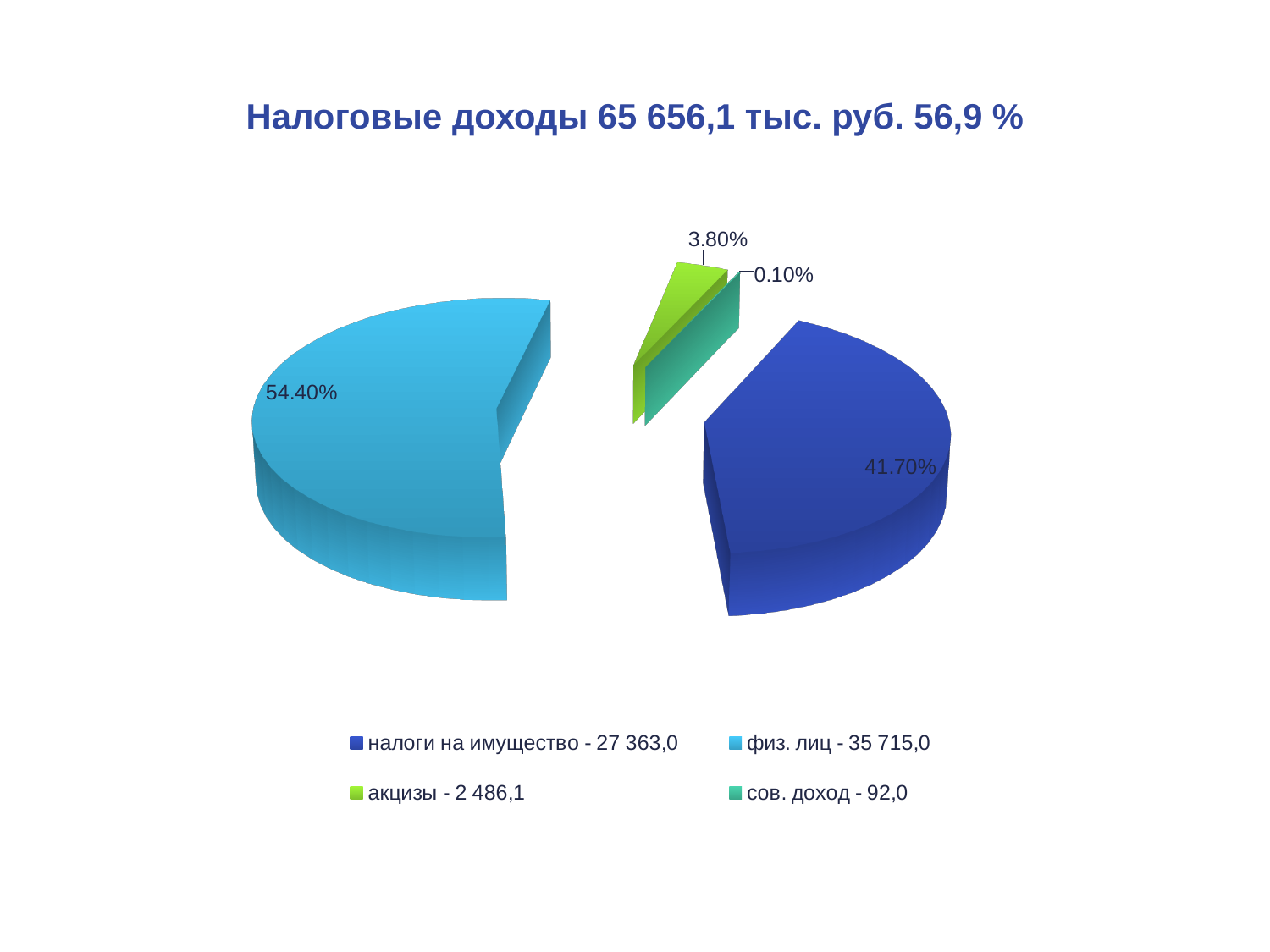
How many slices does the pie chart have? 4 Which category has the largest slice of the pie? физ. лиц - 35 715,0 What share of the pie does the slice for "налоги на имущество - 27 363,0" represent? 41.70% What share of the pie does the slice for "физ. лиц - 35 715,0" represent? 54.40% What kind of chart is shown on the slide? Pie chart What is the title of the chart? Налоговые доходы 65 656,1 тыс. руб. 56,9 % What colour is the slice for "акцизы - 2 486,1"? Green What share of the pie does the slice for "сов. доход - 92,0" represent? 0.10% Which category has the smallest slice of the pie? сов. доход - 92,0 What is the difference in percentage points between the "физ. лиц" slice and the "налоги на имущество" slice? 12.70% Which slice is larger: "акцизы - 2 486,1" or "сов. доход - 92,0"? акцизы - 2 486,1